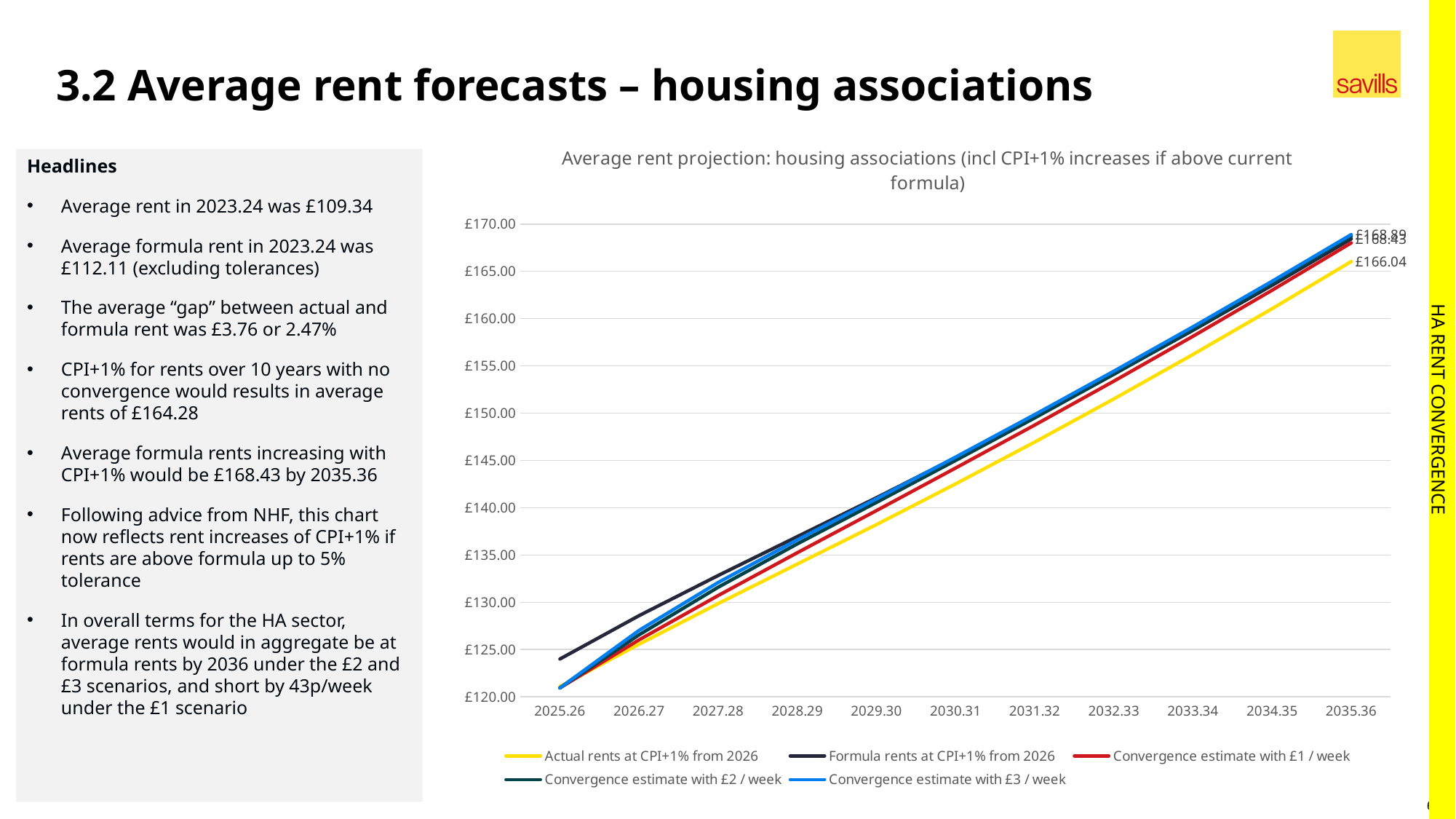
What colour is the line for 'Actual rents at CPI+1% from 2026'? Yellow What is the value of 'Actual rents at CPI+1% from 2026' in 2035.36? £166.04 In 2025.26, which is higher: 'Formula rents at CPI+1% from 2026' or 'Actual rents at CPI+1% from 2026'? Formula rents at CPI+1% from 2026 What kind of chart is shown on the slide? Line chart Is the value for 'Formula rents at CPI+1% from 2026' in 2025.26 greater or less than £120.00? greater What is the title of the chart? Average rent projection: housing associations (incl CPI+1% increases if above current formula) Is the value for 'Actual rents at CPI+1% from 2026' in 2030.31 greater or less than £145.00? less How many years are shown along the x axis of the chart? 11 How many series does the chart's legend list? 5 Do the rent projections rise or fall from 2025.26 to 2035.36? Rise Is the value for 'Convergence estimate with £1 / week' in 2035.36 greater or less than £165.00? greater Which series has the lowest value in 2035.36? Actual rents at CPI+1% from 2026